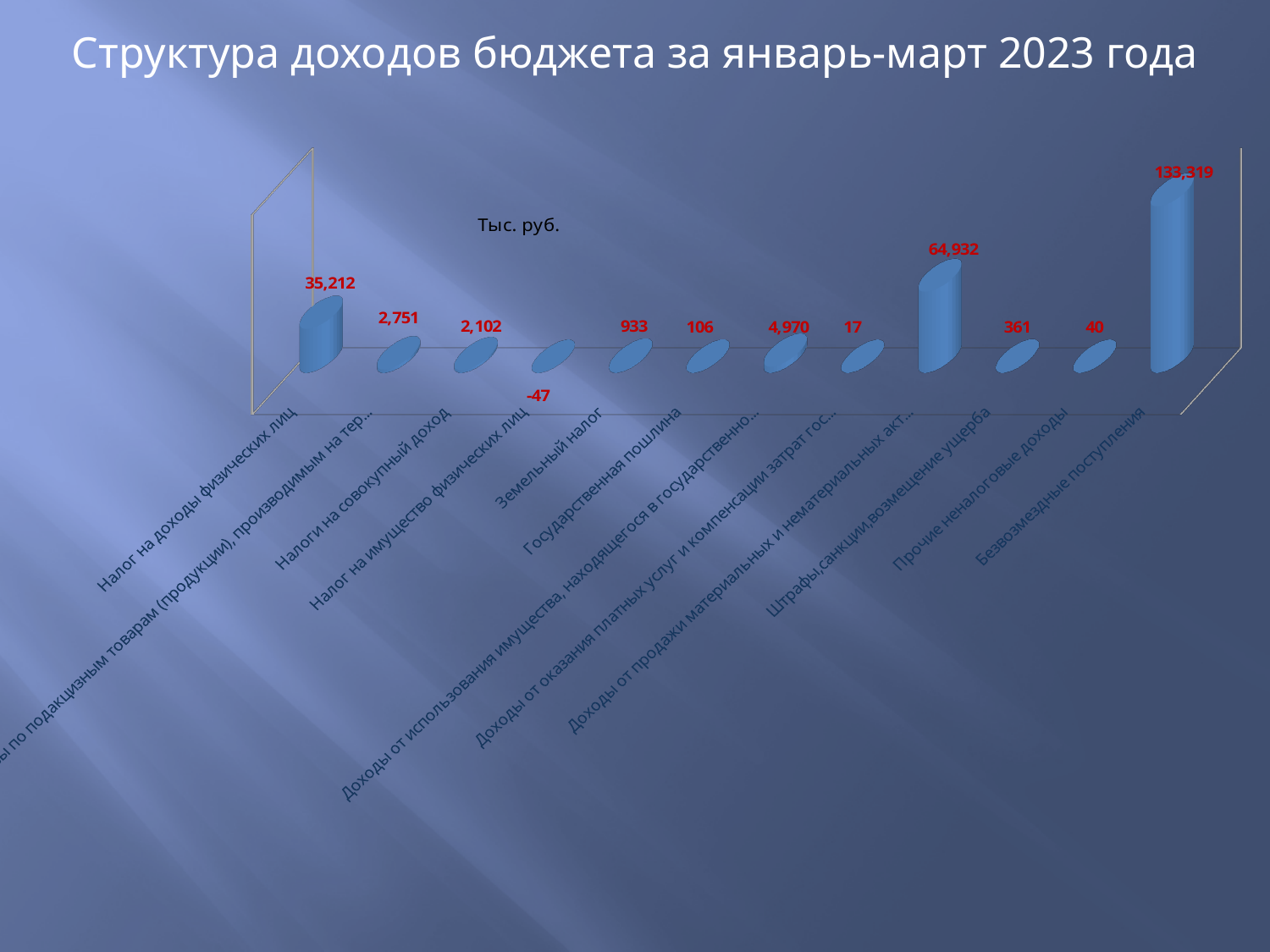
Which is larger: the value for Земельный налог or the value for Государственная пошлина? Земельный налог What is the value for Налог на имущество физических лиц? -47 What kind of chart is shown on the slide? Bar chart What is the value for Земельный налог? 933 What is the value for Прочие неналоговые доходы? 40 Which category has the highest value? Безвозмездные поступления How many categories are plotted on the chart? 12 What is the value for Штрафы,санкции,возмещение ущерба? 361 Which category has the lowest value? Налог на имущество физических лиц What is the value for Безвозмездные поступления? 133,319 What unit is indicated on the chart? Тыс. руб. What is the difference between the values for Безвозмездные поступления and Доходы от продажи материальных и нематериальных акт...? 68,387